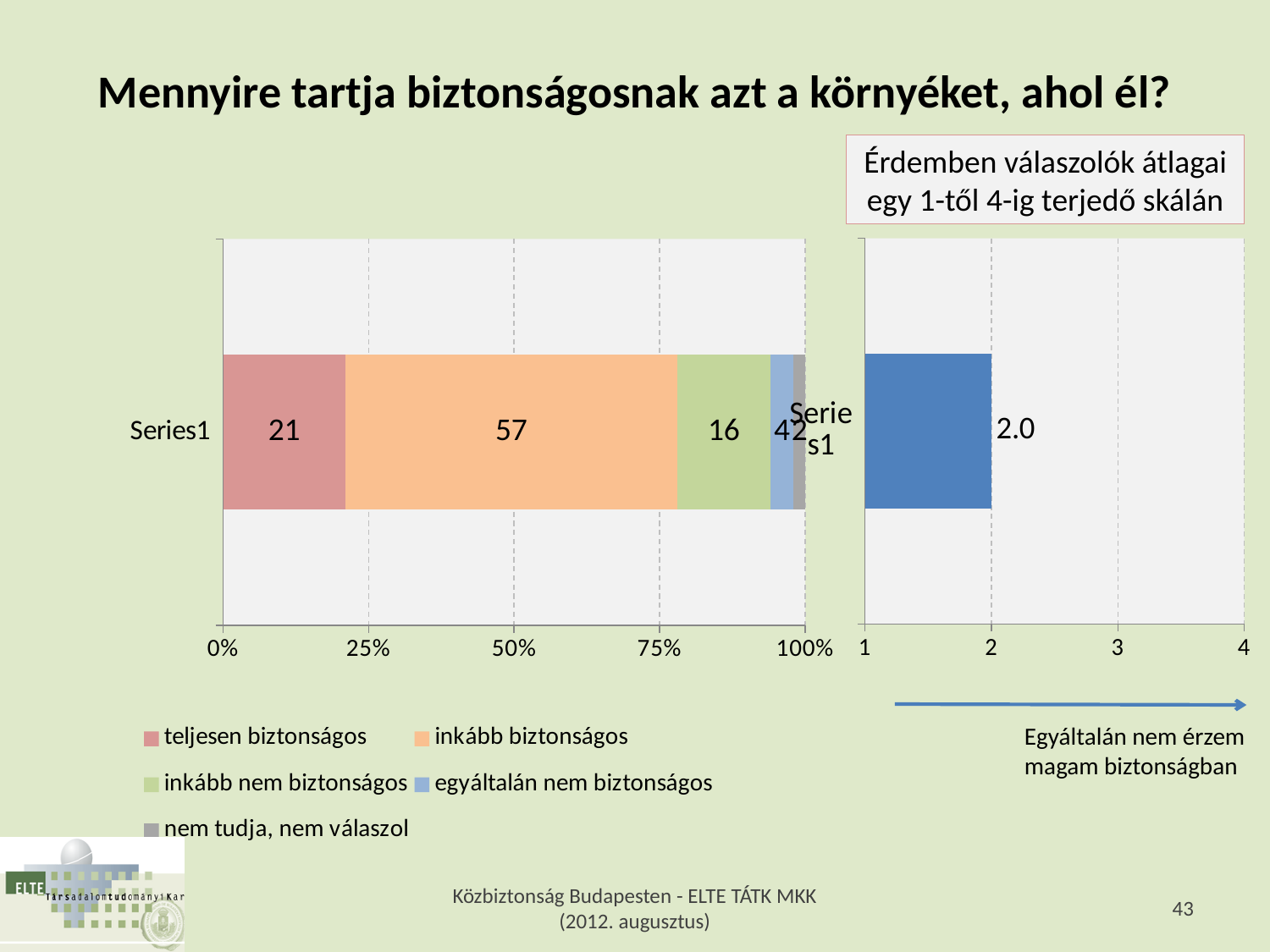
In the left stacked bar chart, what is the value for 'inkább nem biztonságos'? 16 In the left stacked bar chart, what is the difference between the 'inkább biztonságos' and 'teljesen biztonságos' values? 36 In the right chart (Érdemben válaszolók átlagai), is the bar value greater or less than 3? less In the left stacked bar chart, what is the value for 'inkább biztonságos'? 57 In the left stacked bar chart, which legend category has the largest segment? inkább biztonságos In the left stacked bar chart, which is larger: 'teljesen biztonságos' or 'inkább nem biztonságos'? teljesen biztonságos What kind of chart is the left chart on the slide? stacked bar chart In the right chart (Érdemben válaszolók átlagai), what value is shown on the bar? 2.0 In the left stacked bar chart, what is the value for 'teljesen biztonságos'? 21 In the right chart (Érdemben válaszolók átlagai), what is the maximum value shown on the horizontal axis? 4 In the left stacked bar chart, what colour is the 'inkább biztonságos' segment? orange How many series does the legend of the left stacked bar chart list? 5